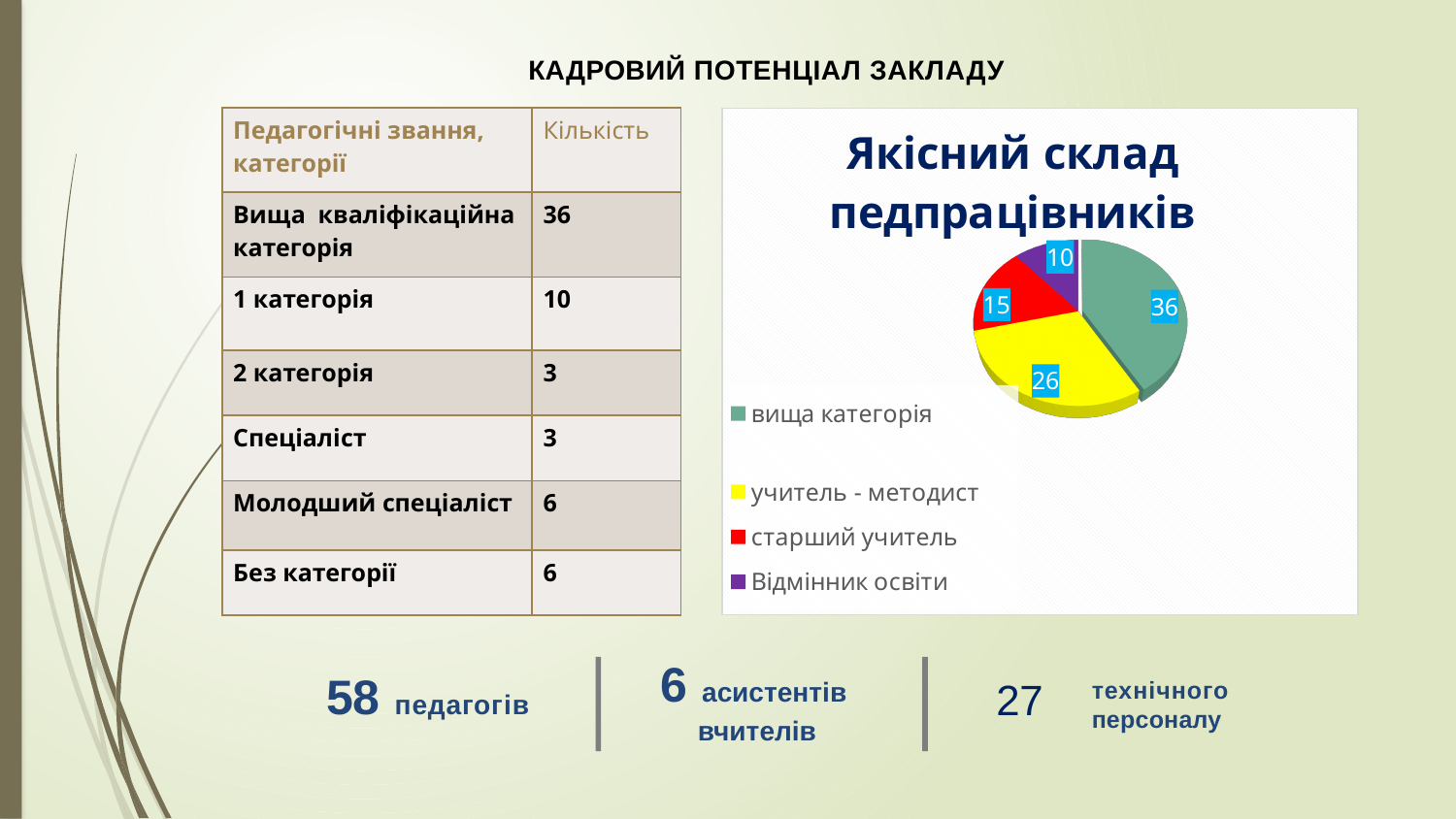
Which is larger: старший учитель or Відмінник освіти? старший учитель What is the value for старший учитель in the pie chart? 15 What is the title of the chart? Якісний склад педпрацівників How many slices does the pie chart have? 4 Which category has the smallest slice in the pie chart? Відмінник освіти What is the value for вища категорія in the pie chart? 36 What colour is the slice for учитель - методист? yellow What is the difference between the values for вища категорія and учитель - методист? 10 What is the value for учитель - методист in the pie chart? 26 What kind of chart is shown on the slide? pie chart Which category has the largest slice in the pie chart? вища категорія What is the value for Відмінник освіти in the pie chart? 10